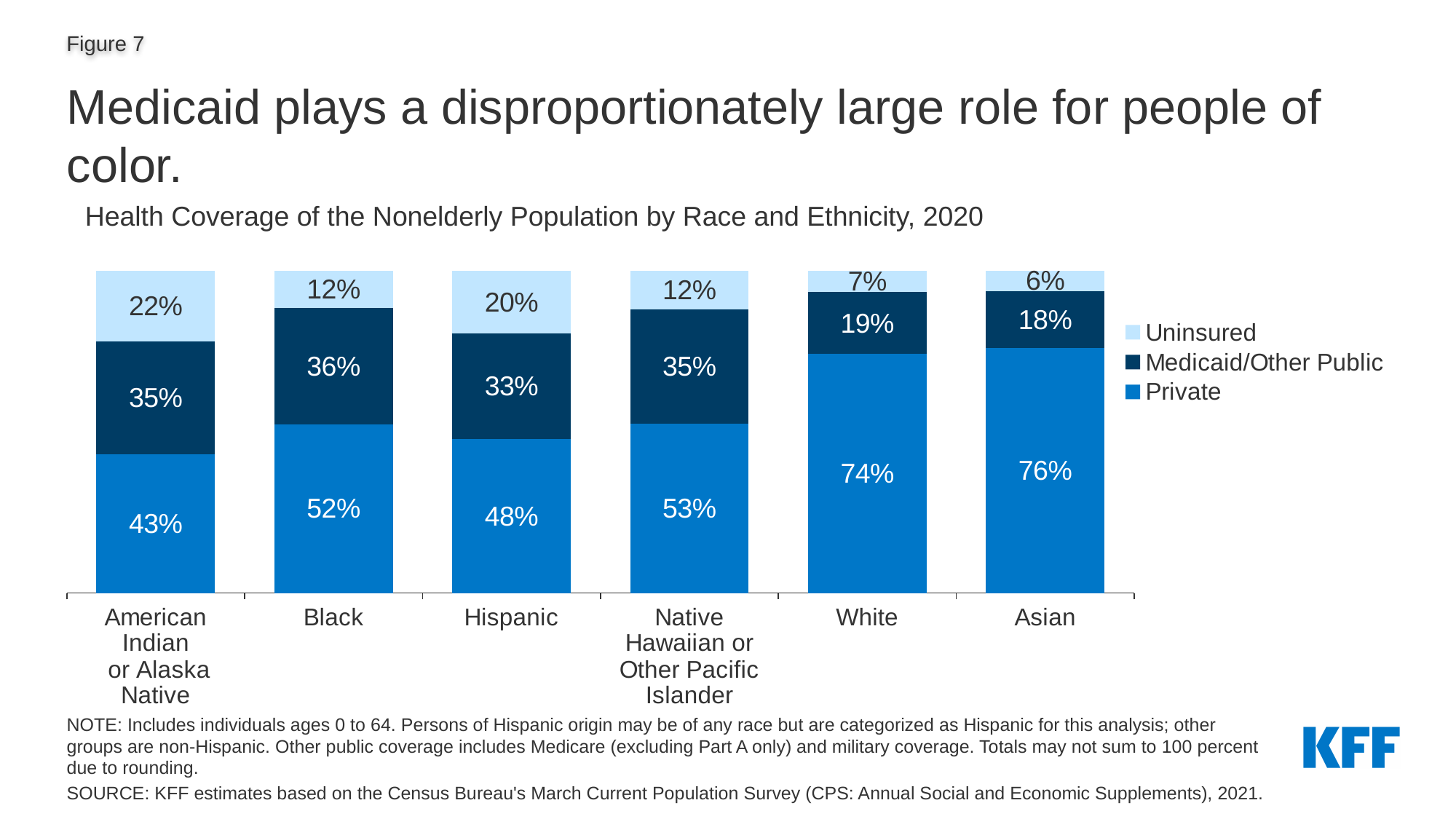
How many series does the legend list? 3 Which group has the lowest Private coverage value? American Indian or Alaska Native What kind of chart is shown on the slide? Stacked bar chart What is the Medicaid/Other Public value for White? 19% What is the total of the stacked bar for Native Hawaiian or Other Pacific Islander? 100% Which group has the lowest Uninsured value? Asian Is the Medicaid/Other Public value larger for Black or for Hispanic? Black What is the Private coverage value for Black? 52% What is the difference between the Private coverage values for Asian and Hispanic? 28% How many race and ethnicity groups are shown on the x axis? 6 Which group has the highest Private coverage value? Asian What is the Uninsured value for American Indian or Alaska Native? 22%